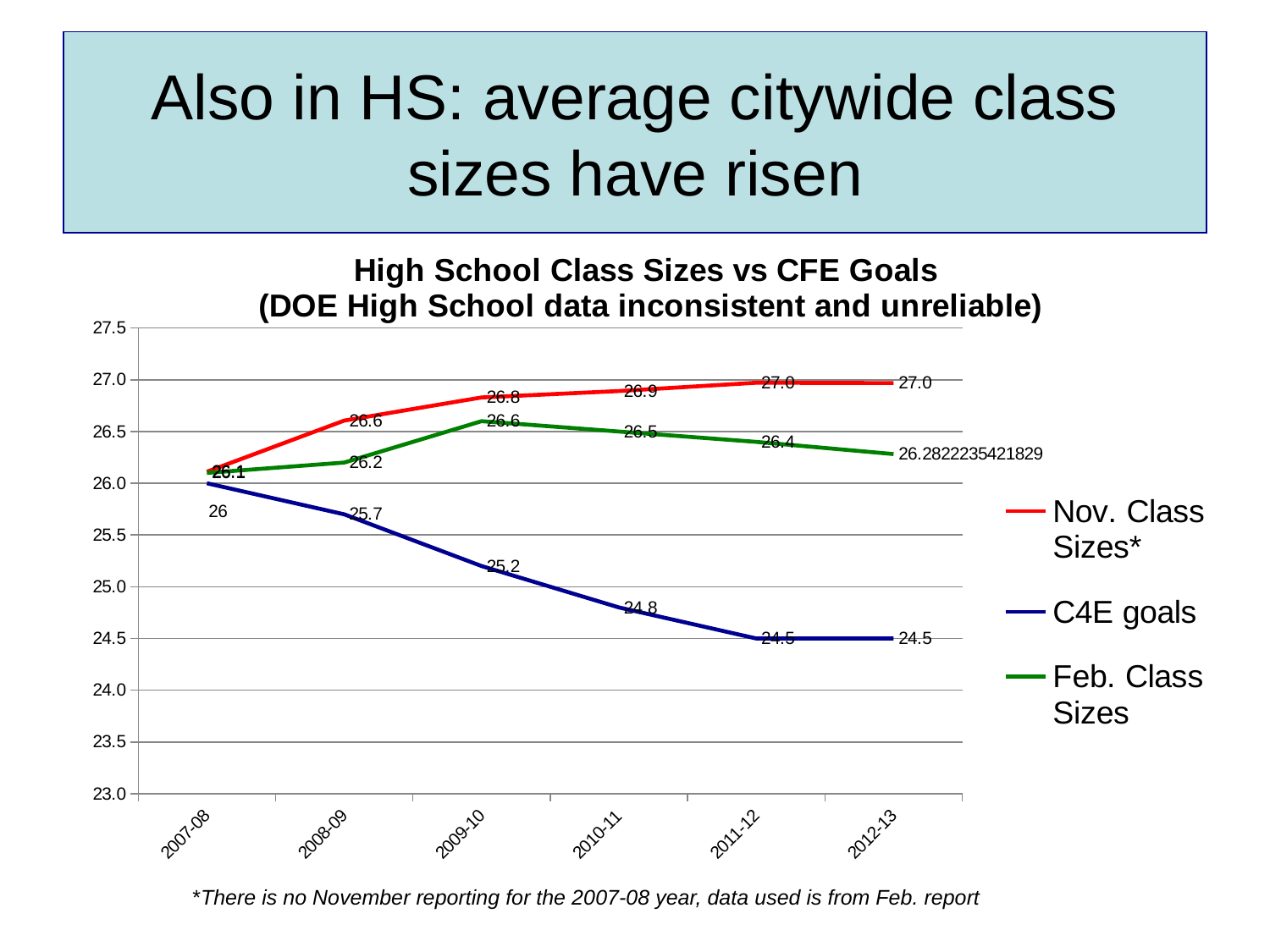
What is the Nov. Class Sizes value for 2011-12? 27.0 Do the C4E goals values rise or fall from 2007-08 to 2012-13? Fall What is the Feb. Class Sizes value for 2012-13? 26.2822235421829 In which year is the Nov. Class Sizes series at its lowest? 2007-08 In 2010-11, which is larger: Nov. Class Sizes or Feb. Class Sizes? Nov. Class Sizes What kind of chart is shown on the slide? Line chart How many series does the legend list? 3 What is the C4E goals value for 2009-10? 25.2 What is the difference between the Nov. Class Sizes value and the C4E goals value in 2012-13? 2.5 In which year is the Feb. Class Sizes series at its highest? 2009-10 What is the title of the chart? High School Class Sizes vs CFE Goals (DOE High School data inconsistent and unreliable) How many school years are plotted along the x axis? 6